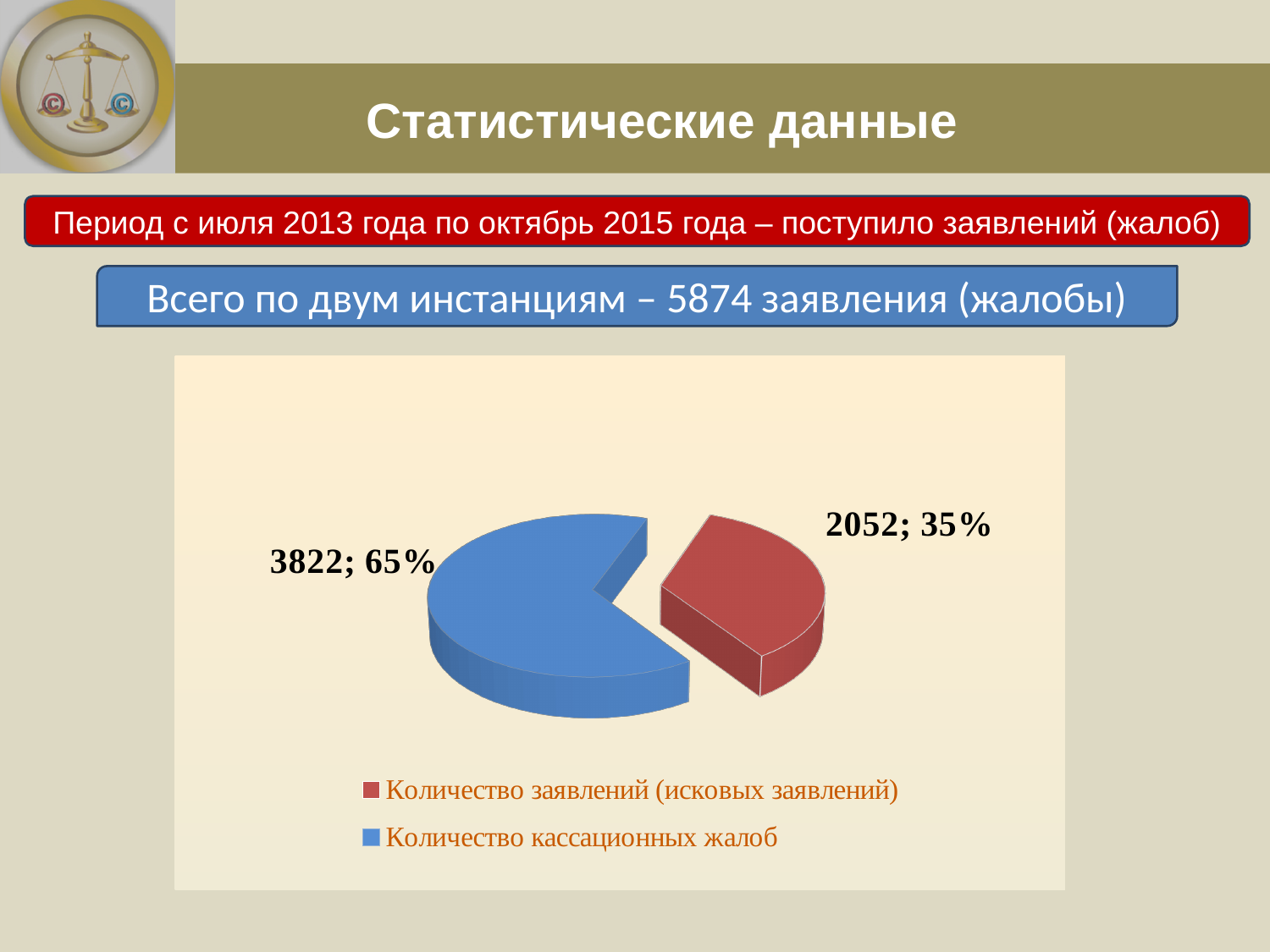
What is the value for "Количество заявлений (исковых заявлений)" in the pie chart? 2052 What is the value for "Количество кассационных жалоб" in the pie chart? 3822 What colour is the slice for "Количество заявлений (исковых заявлений)" in the pie chart? Red How many entries does the legend of the pie chart list? 2 How many slices does the pie chart have? 2 What is the difference between the values for "Количество кассационных жалоб" and "Количество заявлений (исковых заявлений)"? 1770 Which category has the largest slice in the pie chart? Количество кассационных жалоб What share of the pie does "Количество заявлений (исковых заявлений)" represent? 35% What kind of chart is shown on the slide? Pie chart Which category has the smallest slice in the pie chart? Количество заявлений (исковых заявлений) What share of the pie does "Количество кассационных жалоб" represent? 65% Which is larger: the value for "Количество кассационных жалоб" or for "Количество заявлений (исковых заявлений)"? Количество кассационных жалоб